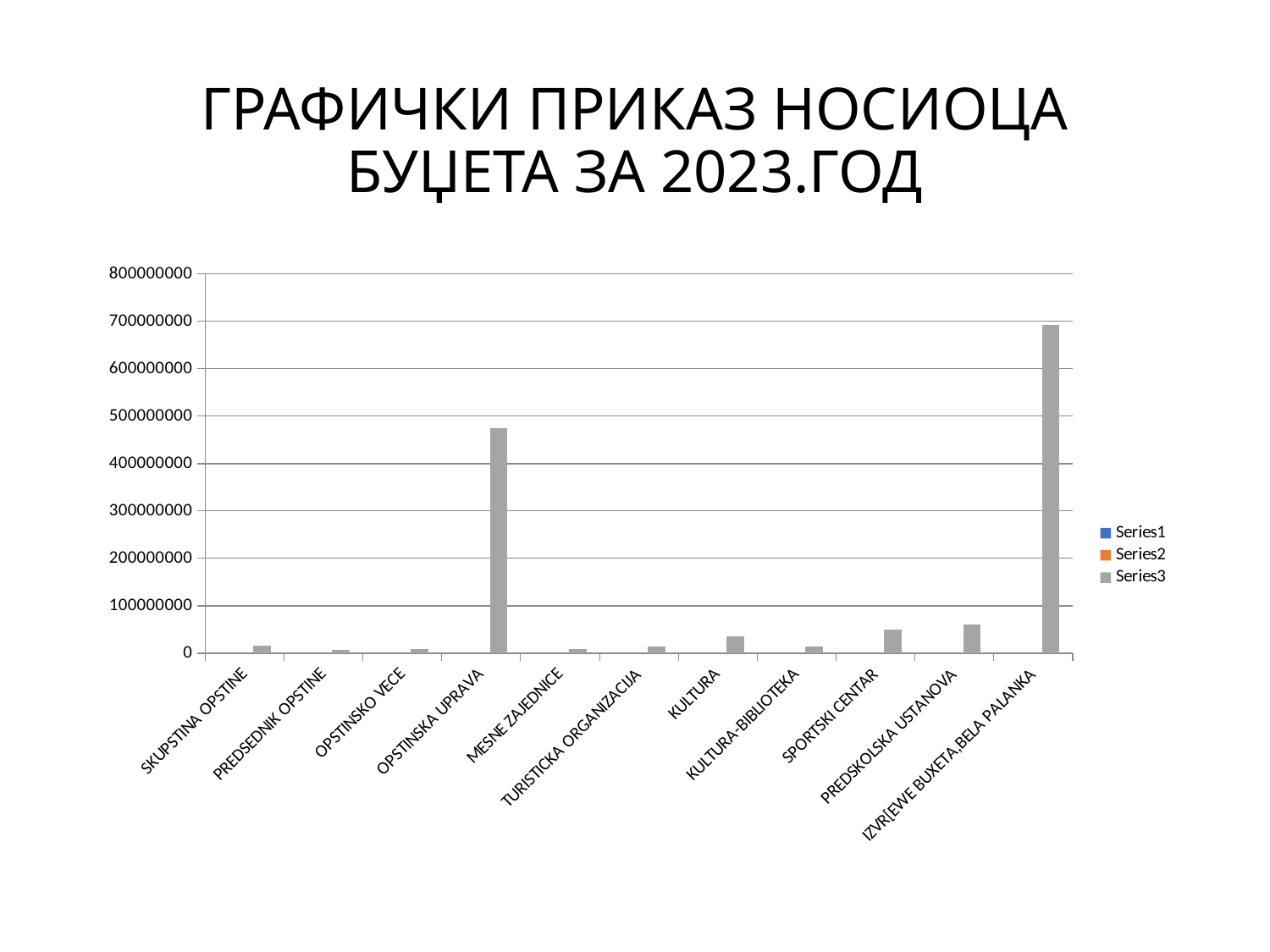
Is the value for IZVR[EWE BUXETA,BELA PALANKA greater or less than 600000000? greater Which has the larger value, KULTURA or KULTURA-BIBLIOTEKA? KULTURA Is the value for SPORTSKI CENTAR greater or less than 100000000? less What kind of chart is shown on the slide? bar chart Which has the larger value, OPSTINSKA UPRAVA or KULTURA? OPSTINSKA UPRAVA How many series does the chart's legend list? 3 Which legend entry corresponds to the gray bars in the chart? Series3 Is the value for PREDSKOLSKA USTANOVA greater or less than 100000000? less What is the title of the chart on the slide? ГРАФИЧКИ ПРИКАЗ НОСИОЦА БУЏЕТА ЗА 2023.ГОД Which category has the highest bar in the chart? IZVR[EWE BUXETA,BELA PALANKA How many categories are shown on the x axis of the chart? 11